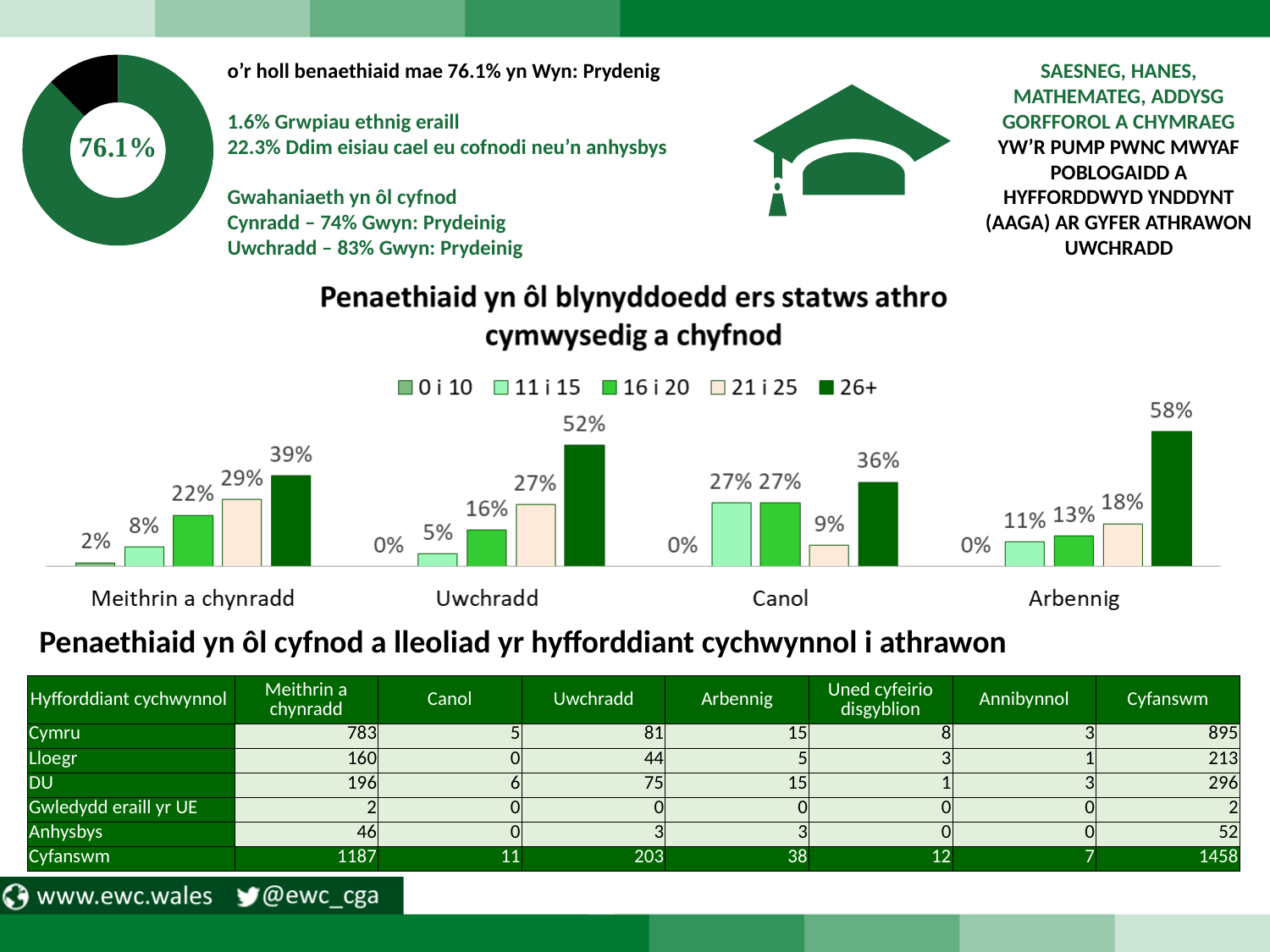
How many categories are shown on the x axis of the bar chart 'Penaethiaid yn ôl blynyddoedd ers statws athro cymwysedig a chyfnod'? 4 In the bar chart 'Penaethiaid yn ôl blynyddoedd ers statws athro cymwysedig a chyfnod', what is the difference between the 26+ value and the 21 i 25 value in the Uwchradd category? 25% In the bar chart 'Penaethiaid yn ôl blynyddoedd ers statws athro cymwysedig a chyfnod', what is the value for the 26+ series in the Uwchradd category? 52% In the bar chart 'Penaethiaid yn ôl blynyddoedd ers statws athro cymwysedig a chyfnod', do the values in the Meithrin a chynradd category rise or fall from the 0 i 10 series to the 26+ series? Rise How many series does the legend of the bar chart 'Penaethiaid yn ôl blynyddoedd ers statws athro cymwysedig a chyfnod' list? 5 What kind of chart is 'Penaethiaid yn ôl blynyddoedd ers statws athro cymwysedig a chyfnod'? Bar chart In the bar chart 'Penaethiaid yn ôl blynyddoedd ers statws athro cymwysedig a chyfnod', which series has the lowest value in the Canol category? 0 i 10 In the bar chart 'Penaethiaid yn ôl blynyddoedd ers statws athro cymwysedig a chyfnod', which is larger: the 16 i 20 value for Meithrin a chynradd or the 16 i 20 value for Arbennig? Meithrin a chynradd What percentage is shown in the centre of the donut chart at the top left of the slide? 76.1% In the bar chart 'Penaethiaid yn ôl blynyddoedd ers statws athro cymwysedig a chyfnod', what is the value for the 21 i 25 series in the Meithrin a chynradd category? 29% In the bar chart 'Penaethiaid yn ôl blynyddoedd ers statws athro cymwysedig a chyfnod', which category has the highest value for the 26+ series? Arbennig In the bar chart 'Penaethiaid yn ôl blynyddoedd ers statws athro cymwysedig a chyfnod', what is the value for the 11 i 15 series in the Arbennig category? 11%